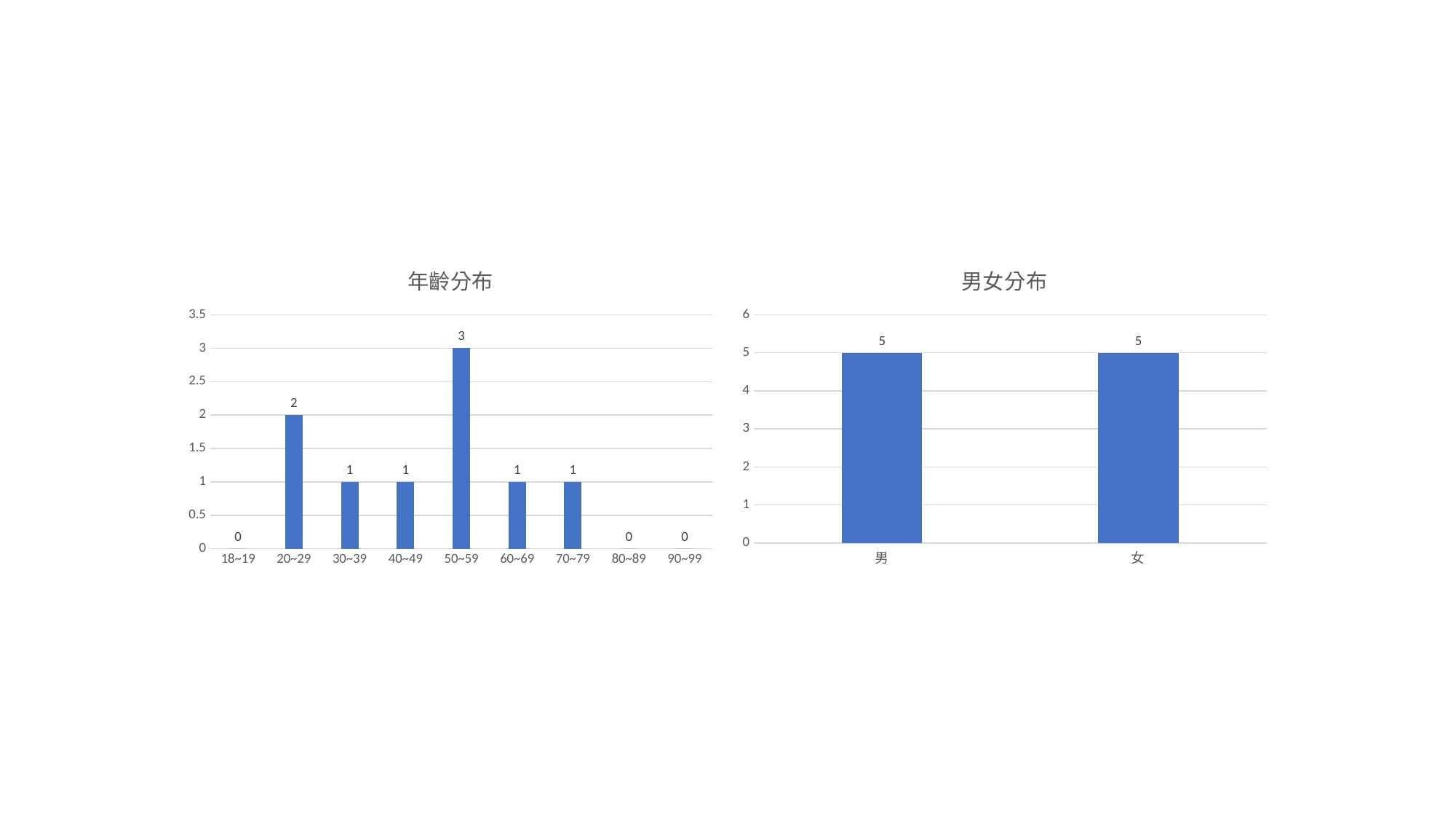
In the 年齢分布 chart, what is the difference between the values for 50~59 and 20~29? 1 What is the title of the chart on the right side of the slide? 男女分布 In the 年齢分布 chart, how many age groups are shown on the x axis? 9 In the 男女分布 chart, what is the value for 女? 5 In the 男女分布 chart, what is the value for 男? 5 In the 年齢分布 chart, what is the value for the 20~29 age group? 2 In the 年齢分布 chart, which age group has the highest value? 50~59 In the 男女分布 chart, what is the difference between the values for 男 and 女? 0 In the 年齢分布 chart, how many age groups have a value of 0? 3 In the 年齢分布 chart, what is the value for the 50~59 age group? 3 In the 年齢分布 chart, which is larger, the value for 20~29 or the value for 30~39? 20~29 What kind of chart is the 年齢分布 chart? bar chart